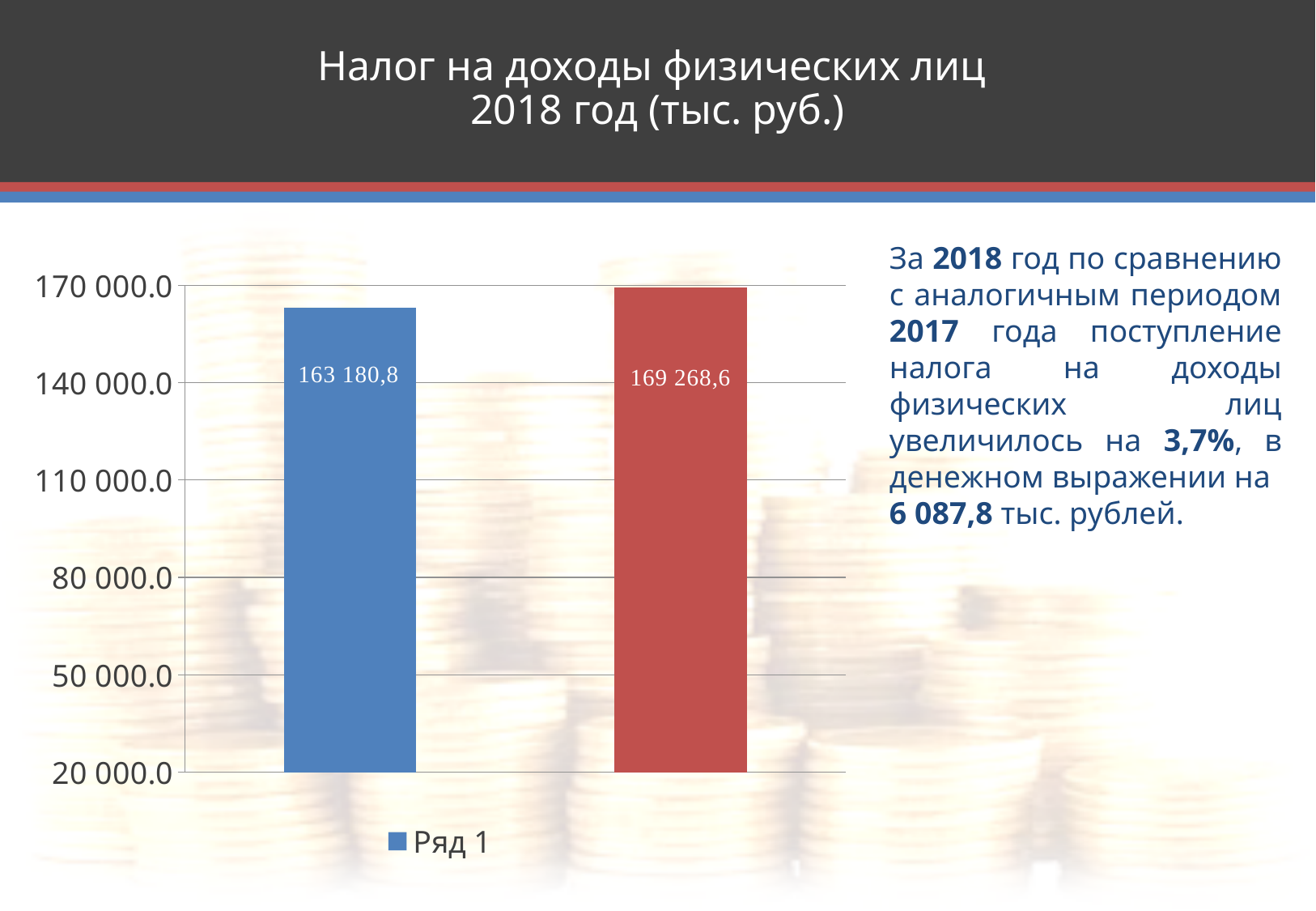
Is the value of the red bar larger or smaller than the value of the blue bar? larger What kind of chart is shown on the slide? bar chart How many bars are plotted in the chart? 2 Which bar has the lowest value? the blue (left) bar Which bar is taller, the blue (left) bar or the red (right) bar? the red (right) bar What value is shown on the red bar (right bar)? 169 268,6 What is the legend entry shown below the chart? Ряд 1 Is the value of the red bar greater or less than 170 000.0? less What value is shown on the blue bar (left bar)? 163 180,8 How many series does the legend list? 1 Is the value of the blue bar greater or less than 140 000.0? greater What is the difference between the red bar value (169 268,6) and the blue bar value (163 180,8)? 6 087,8